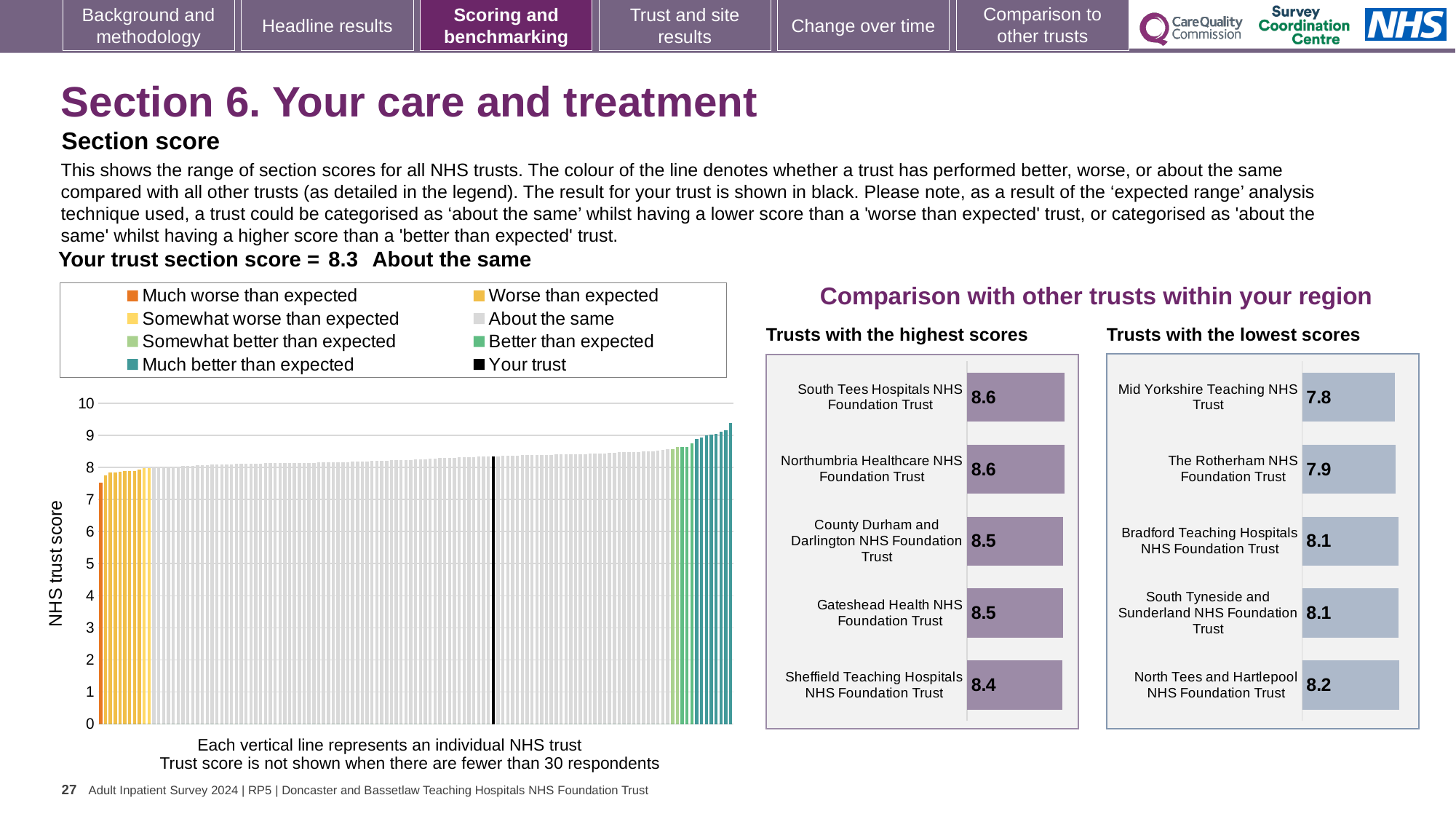
In the large chart on the left, do the trust scores rise or fall from left to right along the x axis? Rise In the 'Trusts with the highest scores' chart, what is the difference between the scores of South Tees Hospitals NHS Foundation Trust and Sheffield Teaching Hospitals NHS Foundation Trust? 0.2 What kind of chart is the large chart on the left showing NHS trust scores? Bar chart In the 'Trusts with the highest scores' chart, what is the score for Sheffield Teaching Hospitals NHS Foundation Trust? 8.4 In the 'Trusts with the lowest scores' chart, what is the difference between the scores of North Tees and Hartlepool NHS Foundation Trust and Mid Yorkshire Teaching NHS Trust? 0.4 In the 'Trusts with the lowest scores' chart, which trust has the lowest score? Mid Yorkshire Teaching NHS Trust In the 'Trusts with the lowest scores' chart, which trust has the highest score? North Tees and Hartlepool NHS Foundation Trust How many entries does the legend of the large chart on the left list? 8 In the 'Trusts with the lowest scores' chart, which has the larger score: The Rotherham NHS Foundation Trust or Bradford Teaching Hospitals NHS Foundation Trust? Bradford Teaching Hospitals NHS Foundation Trust In the 'Trusts with the highest scores' chart, what is the score for South Tees Hospitals NHS Foundation Trust? 8.6 How many trusts are listed in the 'Trusts with the highest scores' chart? 5 In the large chart on the left, is the value for the black 'Your trust' bar greater or less than 8? greater